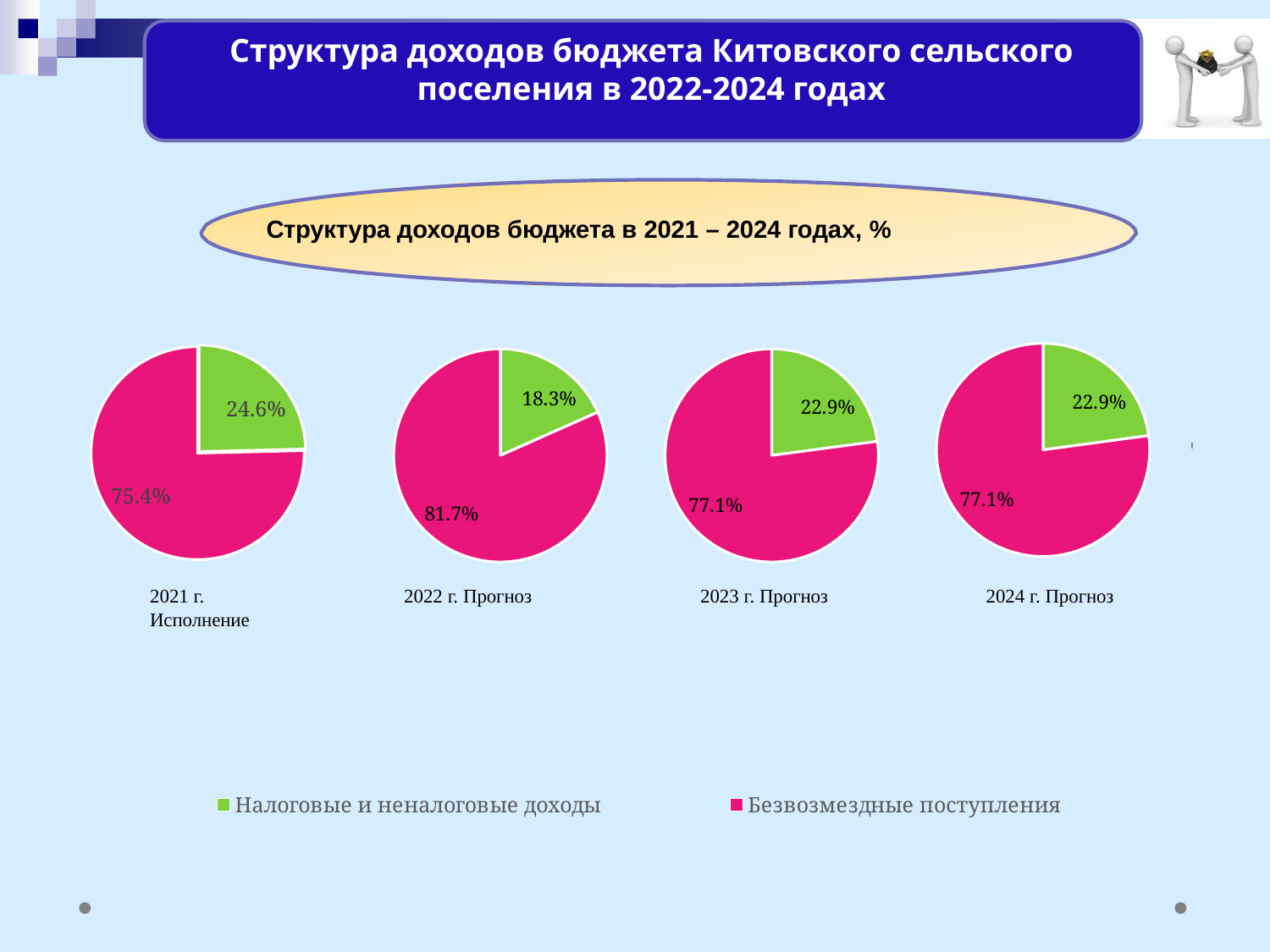
In the 2022 г. Прогноз pie chart, what share is shown for Налоговые и неналоговые доходы? 18.3% How many series does the legend list for the pie charts? 2 Is the share of Налоговые и неналоговые доходы larger in the 2021 г. Исполнение pie chart or in the 2022 г. Прогноз pie chart? 2021 г. Исполнение In the 2021 г. Исполнение pie chart, what share is shown for Безвозмездные поступления? 75.4% In the 2022 г. Прогноз pie chart, what share is shown for Безвозмездные поступления? 81.7% In the 2022 г. Прогноз pie chart, which category has the larger share? Безвозмездные поступления How many pie charts are shown on the slide? 4 In the 2023 г. Прогноз pie chart, what share is shown for Безвозмездные поступления? 77.1% In the 2021 г. Исполнение pie chart, what share is shown for Налоговые и неналоговые доходы? 24.6% What is the difference between the share of Безвозмездные поступления and the share of Налоговые и неналоговые доходы in the 2023 г. Прогноз pie chart? 54.2% In the 2021 г. Исполнение pie chart, which category has the smaller share? Налоговые и неналоговые доходы In the 2024 г. Прогноз pie chart, what share is shown for Налоговые и неналоговые доходы? 22.9%